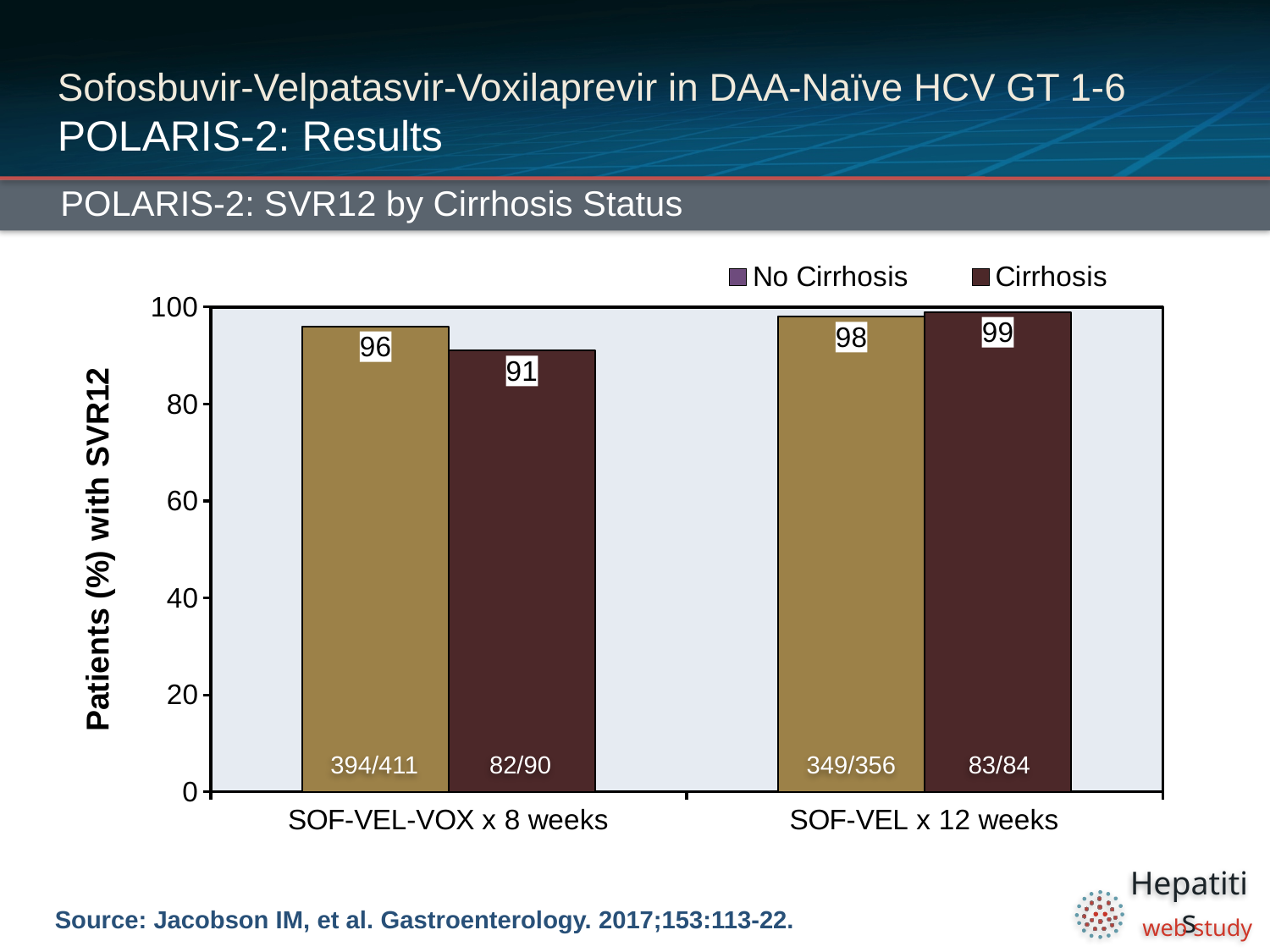
How many treatment groups are shown on the x axis? 2 Which is larger: the No Cirrhosis value for SOF-VEL-VOX x 8 weeks or the No Cirrhosis value for SOF-VEL x 12 weeks? SOF-VEL x 12 weeks What fraction of patients is shown inside the No Cirrhosis bar for SOF-VEL x 12 weeks? 349/356 What is the SVR12 value for Cirrhosis patients in the SOF-VEL x 12 weeks group? 99 How many series does the legend list? 2 What fraction of patients is shown inside the Cirrhosis bar for SOF-VEL-VOX x 8 weeks? 82/90 What type of chart is shown on the slide? Bar chart What is the SVR12 value for No Cirrhosis patients in the SOF-VEL-VOX x 8 weeks group? 96 What is the difference between the No Cirrhosis and Cirrhosis SVR12 values in the SOF-VEL-VOX x 8 weeks group? 5 Which bar has the lowest SVR12 value on the chart? Cirrhosis, SOF-VEL-VOX x 8 weeks What is the SVR12 value for No Cirrhosis patients in the SOF-VEL x 12 weeks group? 98 What is the SVR12 value for Cirrhosis patients in the SOF-VEL-VOX x 8 weeks group? 91